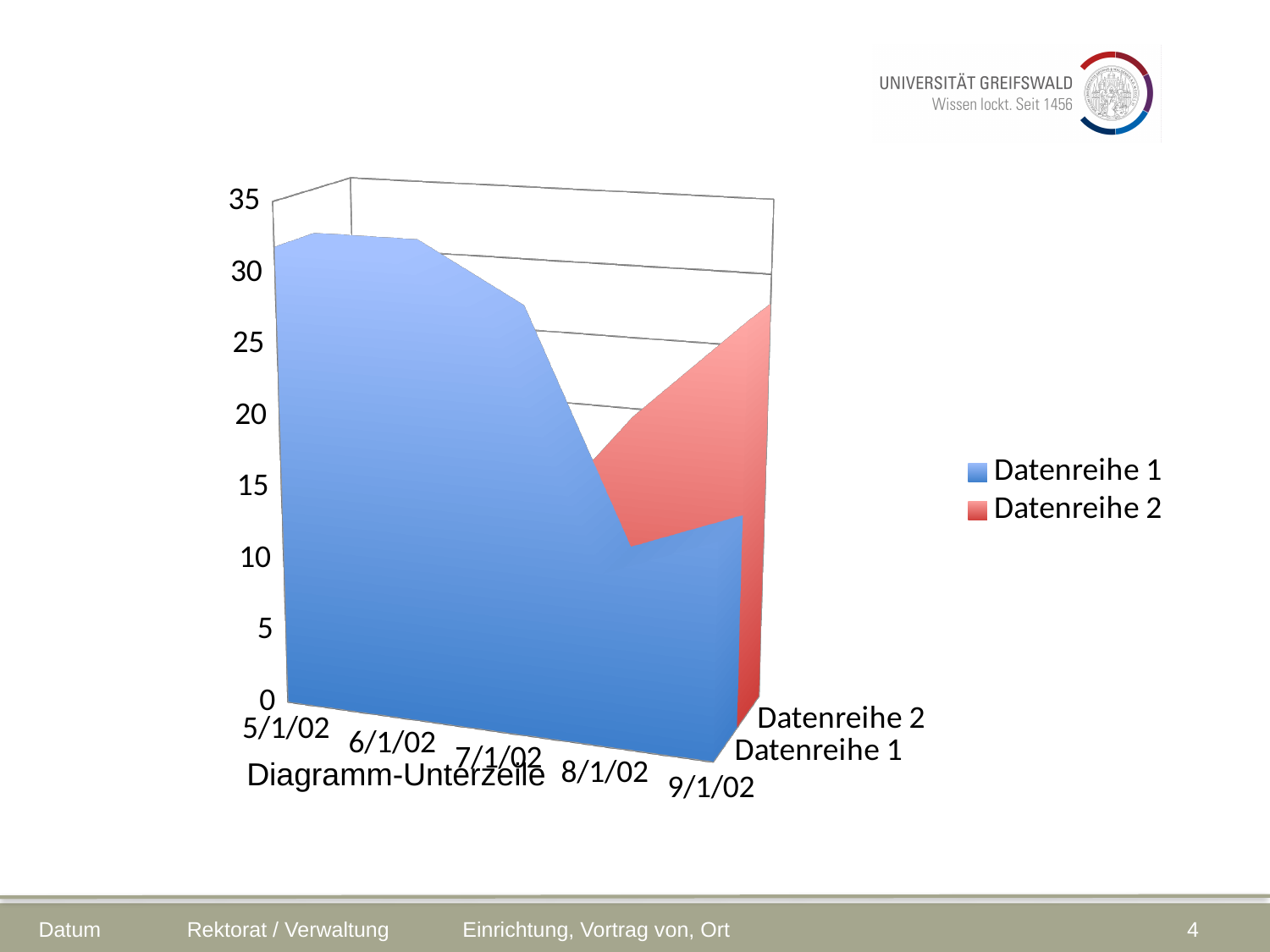
Is the value of Datenreihe 1 at 8/1/02 greater or less than 20? less Does Datenreihe 1 rise or fall from 5/1/02 to 9/1/02? fall What kind of chart is shown on the slide? area chart Which is larger for Datenreihe 1: the value at 5/1/02 or the value at 8/1/02? 5/1/02 Is the value of Datenreihe 2 at 9/1/02 greater or less than 20? greater How many series does the legend list? 2 What is the label shown below the x axis? Diagramm-Unterzeile At 9/1/02, which series has the larger value, Datenreihe 1 or Datenreihe 2? Datenreihe 2 How many dates are shown on the x axis? 5 What are the names of the two series in the legend? Datenreihe 1 and Datenreihe 2 Is the value of Datenreihe 1 at 9/1/02 greater or less than 20? less